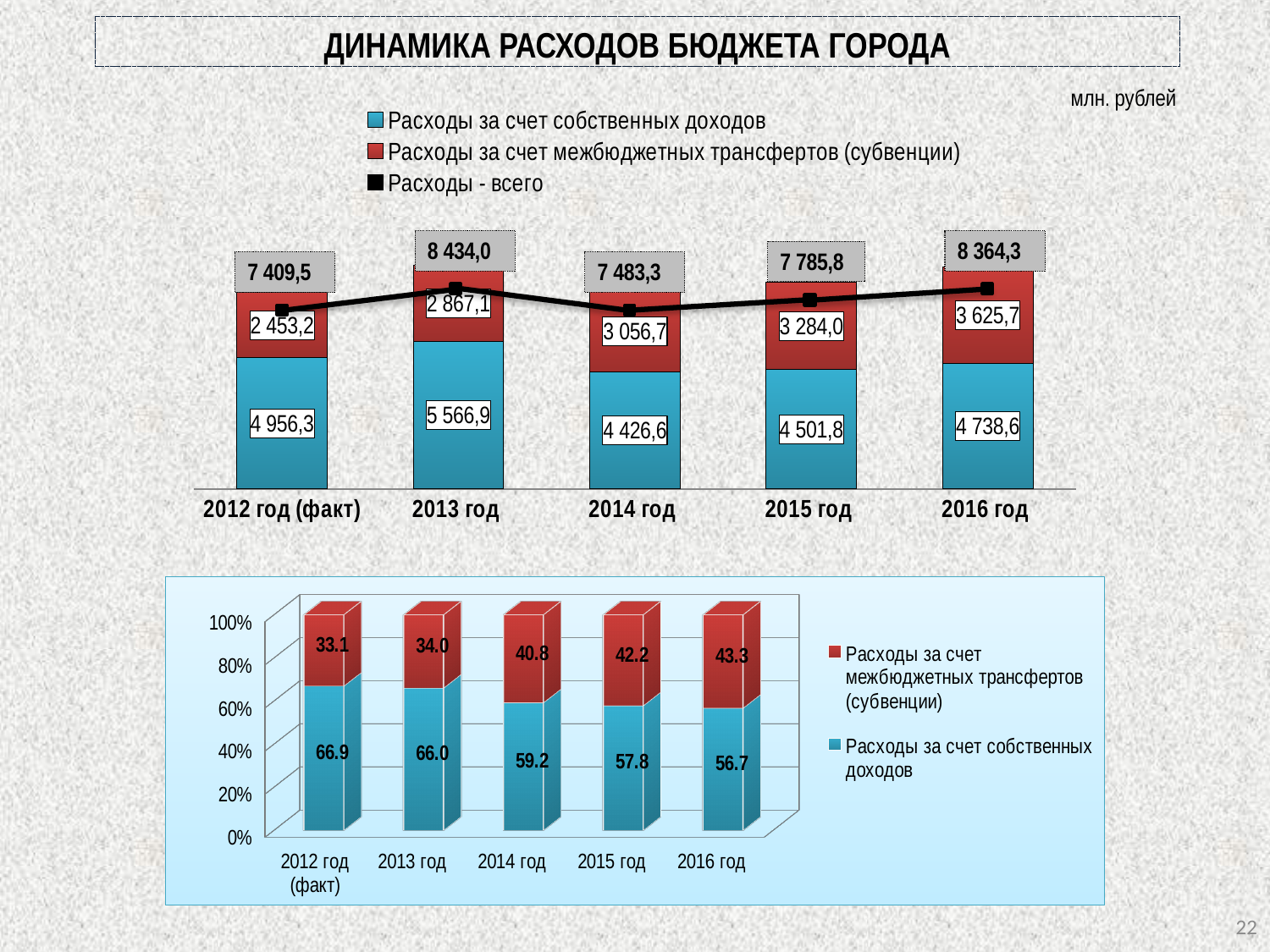
How many years are shown on the x axis of the bottom chart? 5 In the top chart, what is the value of 'Расходы - всего' for 2013 год? 8 434,0 What kind of chart is the bottom chart? stacked bar chart In the top chart, which is larger: 'Расходы за счет собственных доходов' for 2015 год or for 2016 год? 2016 год In the bottom chart, what is the share of 'Расходы за счет межбюджетных трансфертов (субвенции)' for 2014 год? 40.8 In the top chart, which year has the lowest value of 'Расходы за счет межбюджетных трансфертов (субвенции)'? 2012 год (факт) In the bottom chart, does the share of 'Расходы за счет собственных доходов' rise or fall from 2012 год (факт) to 2016 год? fall In the top chart, what is the value of 'Расходы за счет межбюджетных трансфертов (субвенции)' for 2016 год? 3 625,7 In the top chart, which year has the highest value of 'Расходы - всего'? 2013 год In the top chart, what is the value of 'Расходы за счет собственных доходов' for 2014 год? 4 426,6 In the top chart, what is the difference between 'Расходы - всего' for 2016 год and 2015 год? 578,5 How many series does the legend of the top chart list? 3